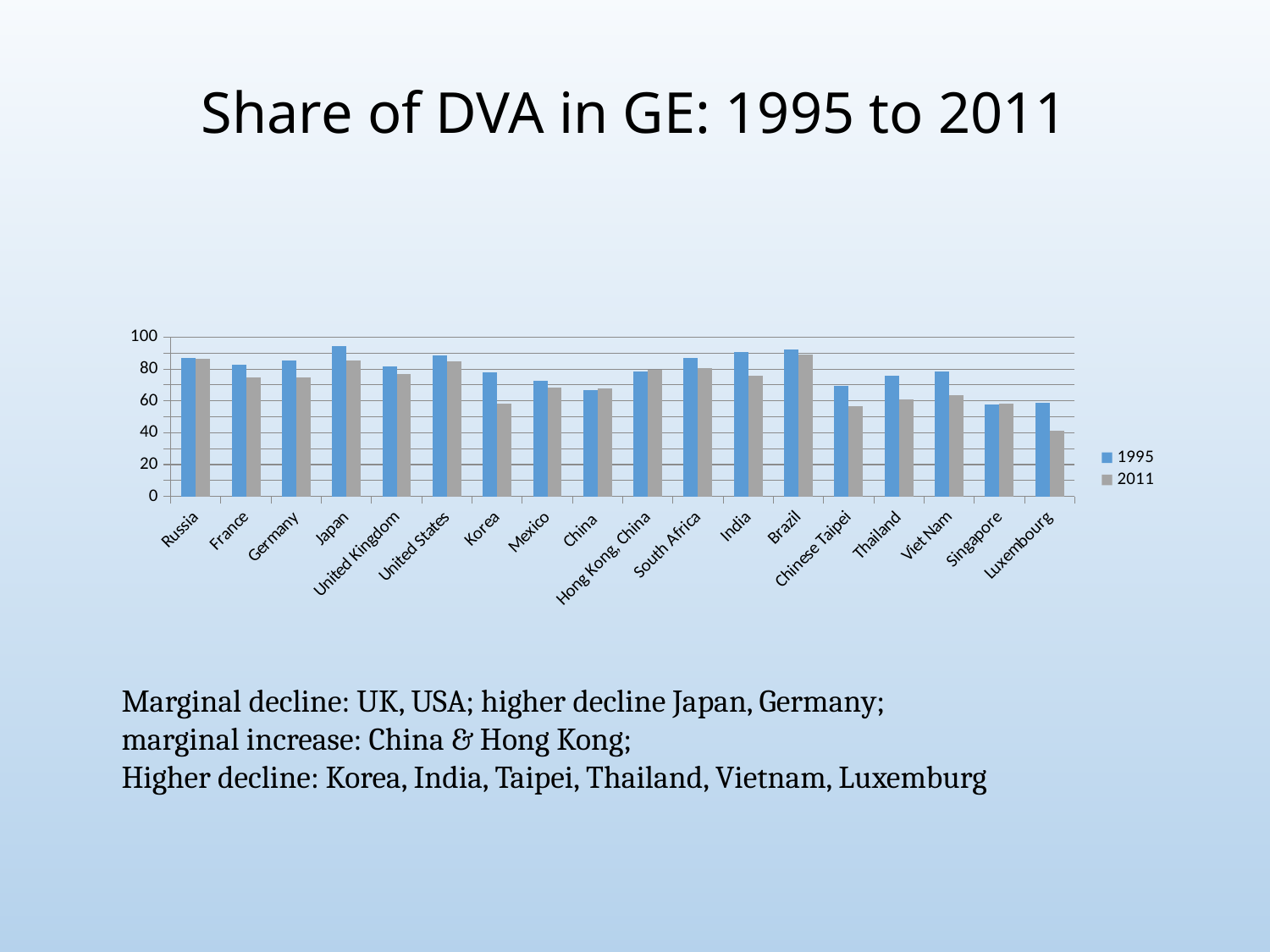
Which economy has the lowest value for 2011? Luxembourg What kind of chart is shown on the slide? Bar chart Is the value for Mexico in 1995 greater or less than 80? less Is the value for Japan in 1995 greater or less than 80? greater Which colour represents the 2011 series in the legend? Grey Is the value for China in 1995 greater or less than 80? less For Luxembourg, which is larger: the 1995 value or the 2011 value? 1995 How many countries or economies are shown on the x axis? 18 For Korea, which is larger: the 1995 value or the 2011 value? 1995 How many series does the legend list? 2